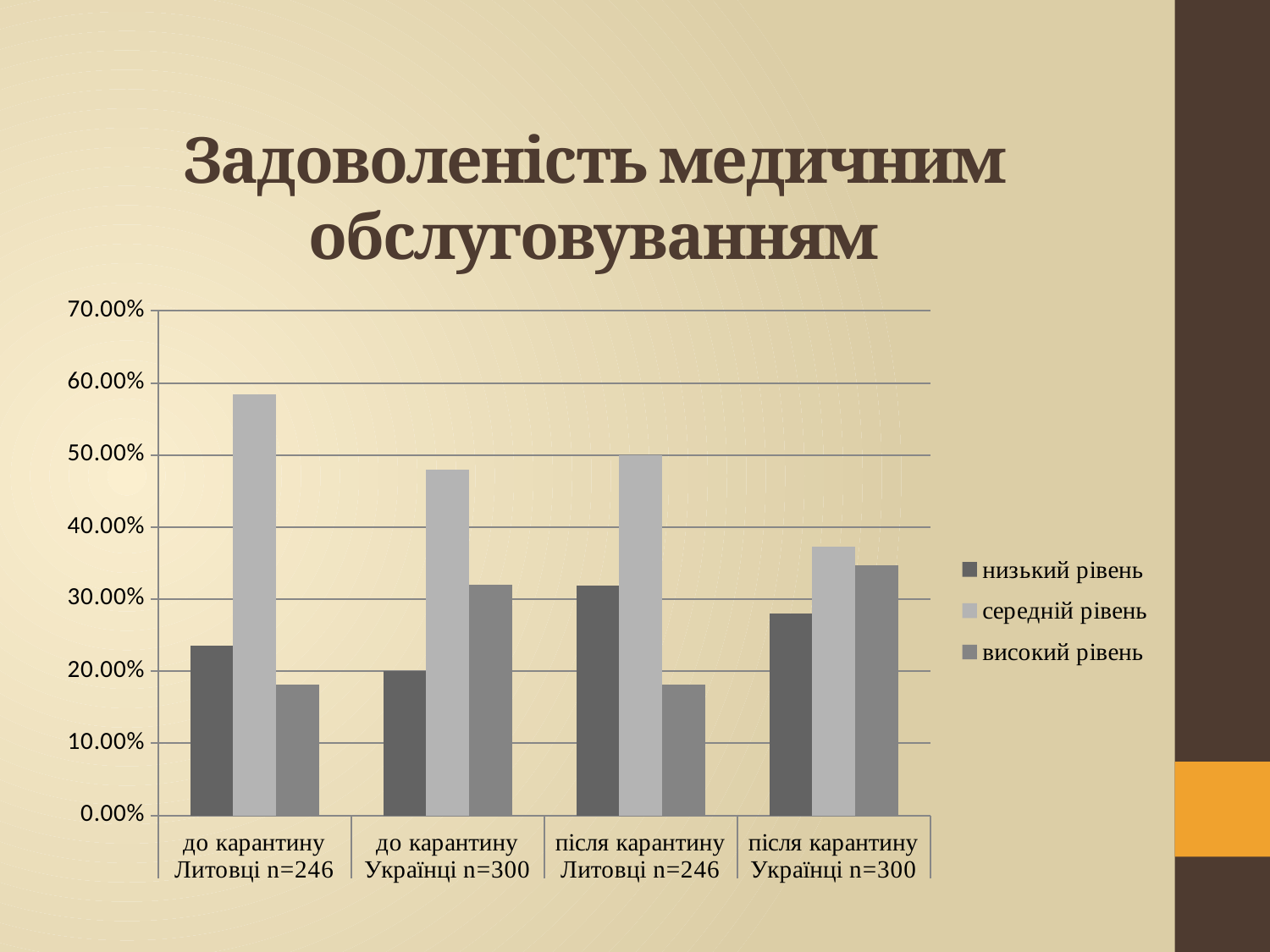
Is the value for середній рівень in the category до карантину Литовці n=246 greater or less than 50.00%? greater Which category has the lowest value for низький рівень? до карантину Українці n=300 Which is larger for низький рівень: після карантину Литовці n=246 or до карантину Литовці n=246? після карантину Литовці n=246 How many series does the legend list? 3 What kind of chart is shown on the slide? bar chart Which category has the highest value for середній рівень? до карантину Литовці n=246 What is the title of the slide? Задоволеність медичним обслуговуванням How many categories are shown on the x axis? 4 Is the value for середній рівень in the category після карантину Українці n=300 greater or less than 40.00%? less Which is larger for високий рівень: до карантину Українці n=300 or до карантину Литовці n=246? до карантину Українці n=300 Is the value for низький рівень in the category після карантину Литовці n=246 greater or less than 30.00%? greater